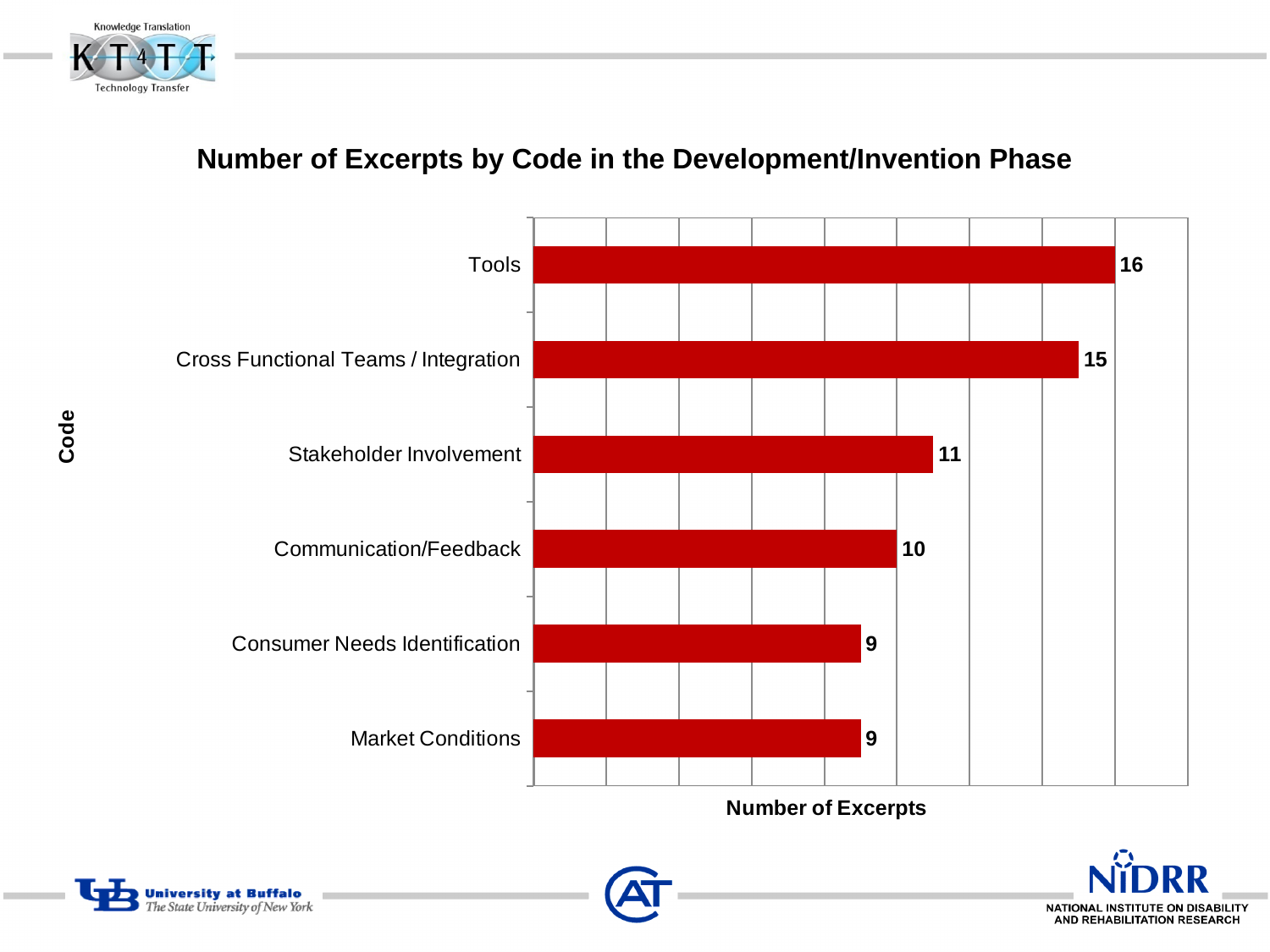
What is the difference in number of excerpts between Tools and Stakeholder Involvement? 5 Which code has the highest number of excerpts? Tools What is the label of the horizontal axis? Number of Excerpts What is the number of excerpts for Tools? 16 What is the difference in number of excerpts between Cross Functional Teams / Integration and Communication/Feedback? 5 Which has more excerpts, Stakeholder Involvement or Consumer Needs Identification? Stakeholder Involvement What is the number of excerpts for Communication/Feedback? 10 What kind of chart is shown on the slide? Bar chart What is the number of excerpts for Stakeholder Involvement? 11 What is the title of the chart? Number of Excerpts by Code in the Development/Invention Phase What is the number of excerpts for Cross Functional Teams / Integration? 15 How many codes are shown in the chart? 6